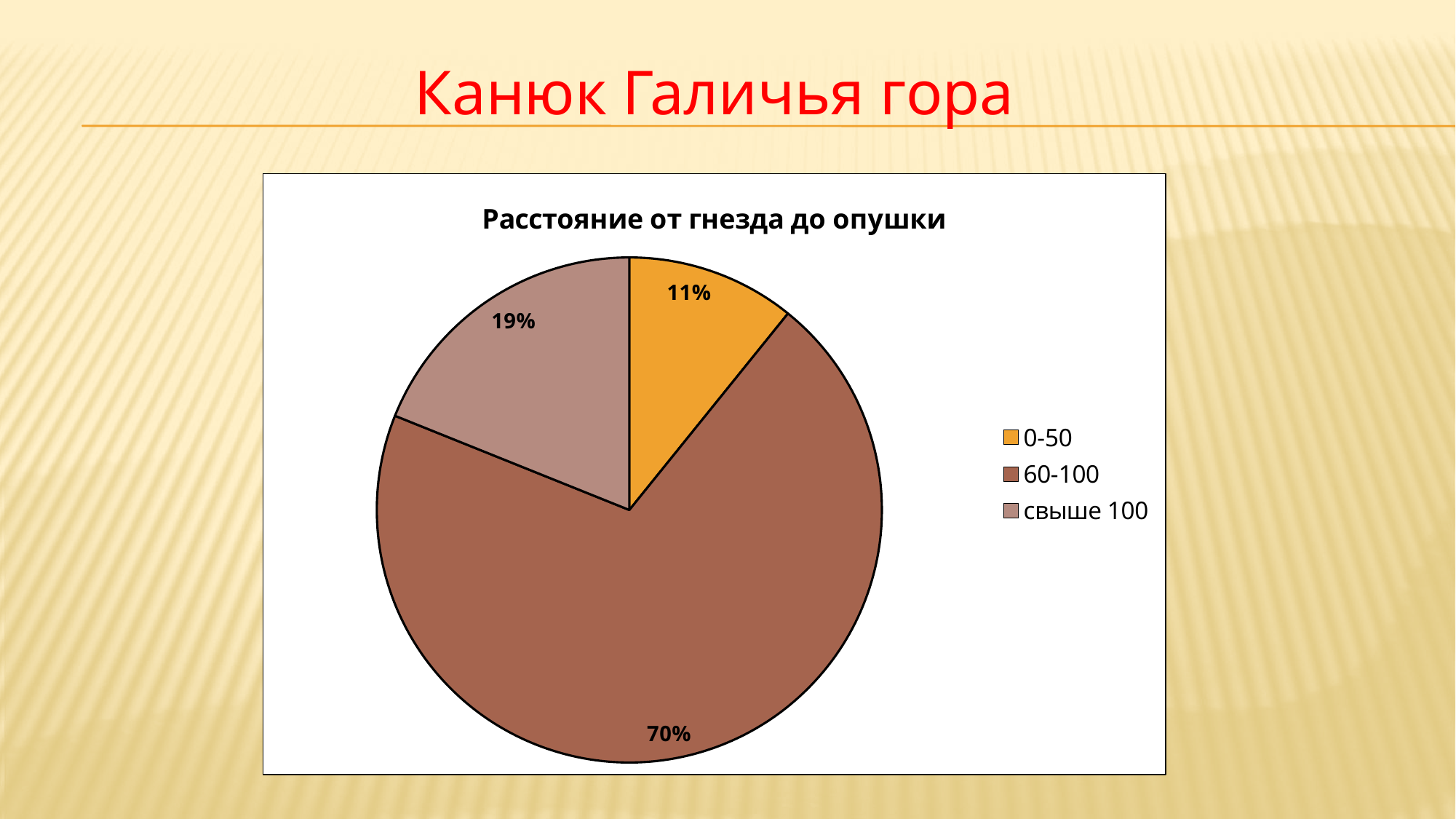
What is the difference between the shares of свыше 100 and 0-50? 8% What share of the pie does the 0-50 category have? 11% Which category has the largest share of the pie? 60-100 What is the title of the chart? Расстояние от гнезда до опушки Which is larger, the share for 0-50 or the share for свыше 100? свыше 100 What kind of chart is shown on the slide? pie chart What is the difference between the shares of 60-100 and свыше 100? 51% Which category has the smallest share of the pie? 0-50 What share of the pie does the 60-100 category have? 70% How many categories does the pie chart have? 3 What share of the pie does the свыше 100 category have? 19% Which category is shown in orange? 0-50